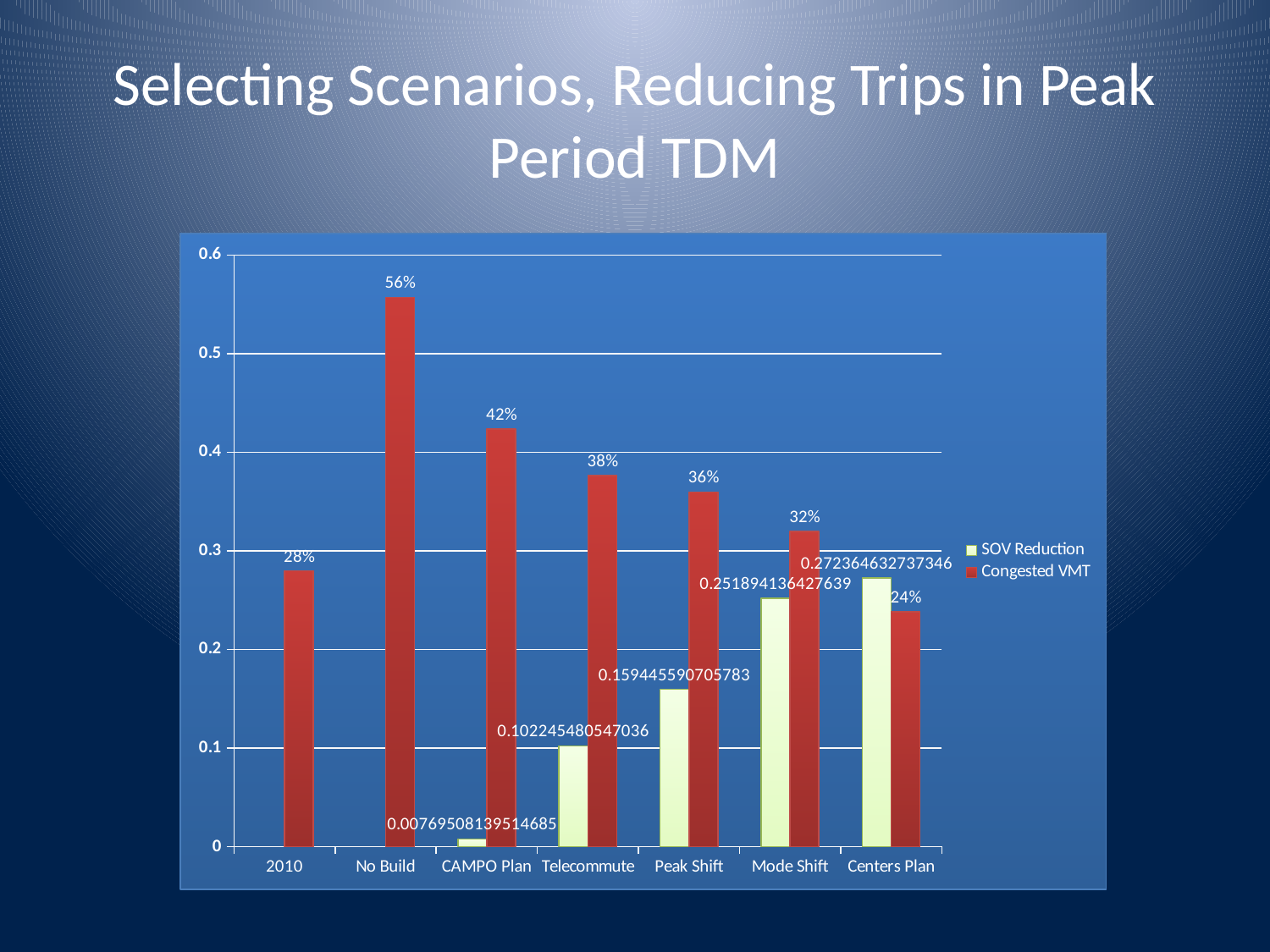
How many series does the legend list? 2 Which has a larger Congested VMT value, Telecommute or Peak Shift? Telecommute What kind of chart is shown on the slide? Bar chart Which category has the highest Congested VMT value? No Build What is the Congested VMT value for Centers Plan? 24% What is the Congested VMT value for No Build? 56% What is the SOV Reduction value for Telecommute? 0.102245480547036 How many categories are shown on the x axis? 7 Which category has the highest SOV Reduction value? Centers Plan Which category has the lowest Congested VMT value? Centers Plan What is the difference between the Congested VMT values for No Build and 2010? 28% What is the SOV Reduction value for Mode Shift? 0.251894136427639